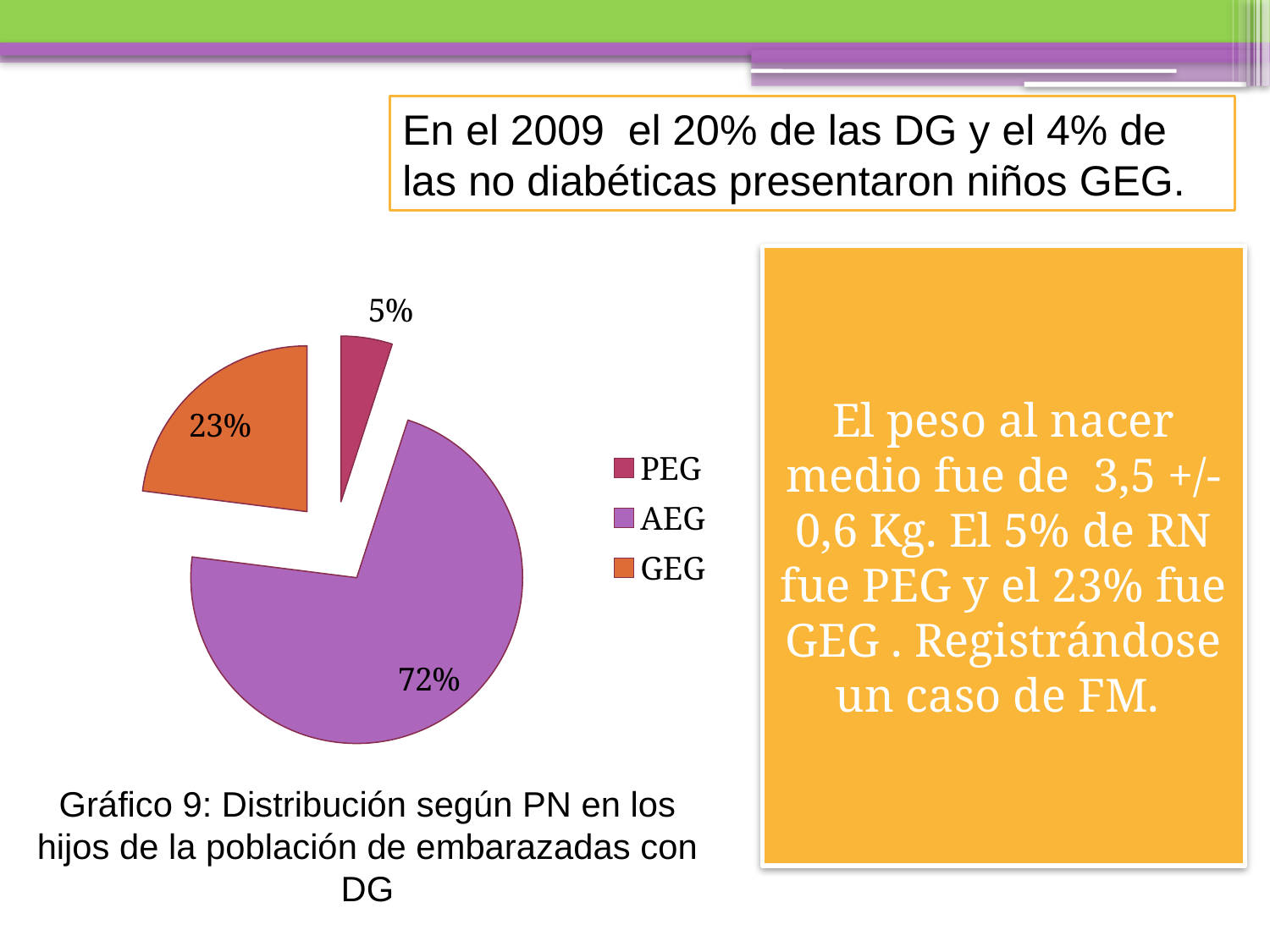
Which category has the largest slice of the pie? AEG What is the difference in percentage points between the GEG and PEG slices? 18 What share of the pie does PEG represent? 5% What colour is the AEG slice in the pie chart? purple What is the difference in percentage points between the AEG and GEG slices? 49 What share of the pie does AEG represent? 72% What kind of chart is shown on the slide? pie chart How many entries does the legend list? 3 How many categories does the pie chart have? 3 Which is larger, the GEG slice or the PEG slice? GEG Which category has the smallest slice of the pie? PEG What share of the pie does GEG represent? 23%